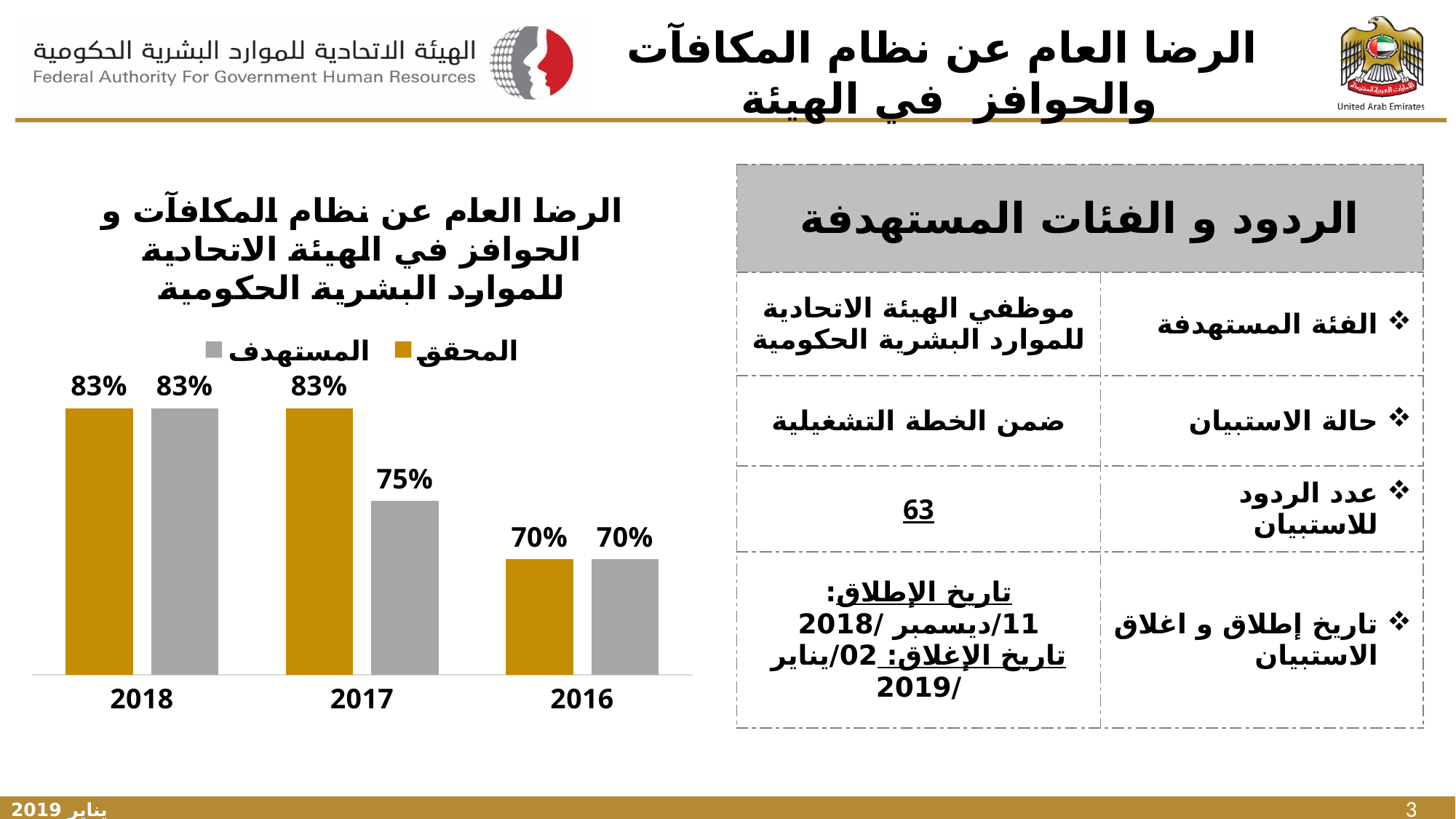
What is the difference between المحقق (achieved) and المستهدف (target) in 2017? 8% How many years are shown on the x axis of the chart? 3 In 2017, which is larger: المحقق (achieved) or المستهدف (target)? المحقق What is the value of المحقق (achieved) for 2016? 70% What is the value of المحقق (achieved) for 2017? 83% Which year has the highest المستهدف (target) value? 2018 What is the difference between the المحقق (achieved) value for 2018 and for 2016? 13% Which year has the lowest المحقق (achieved) value? 2016 What type of chart is shown on the slide? bar chart What is the value of المستهدف (target) for 2018? 83% What is the value of المستهدف (target) for 2017? 75% How many series does the chart legend list? 2